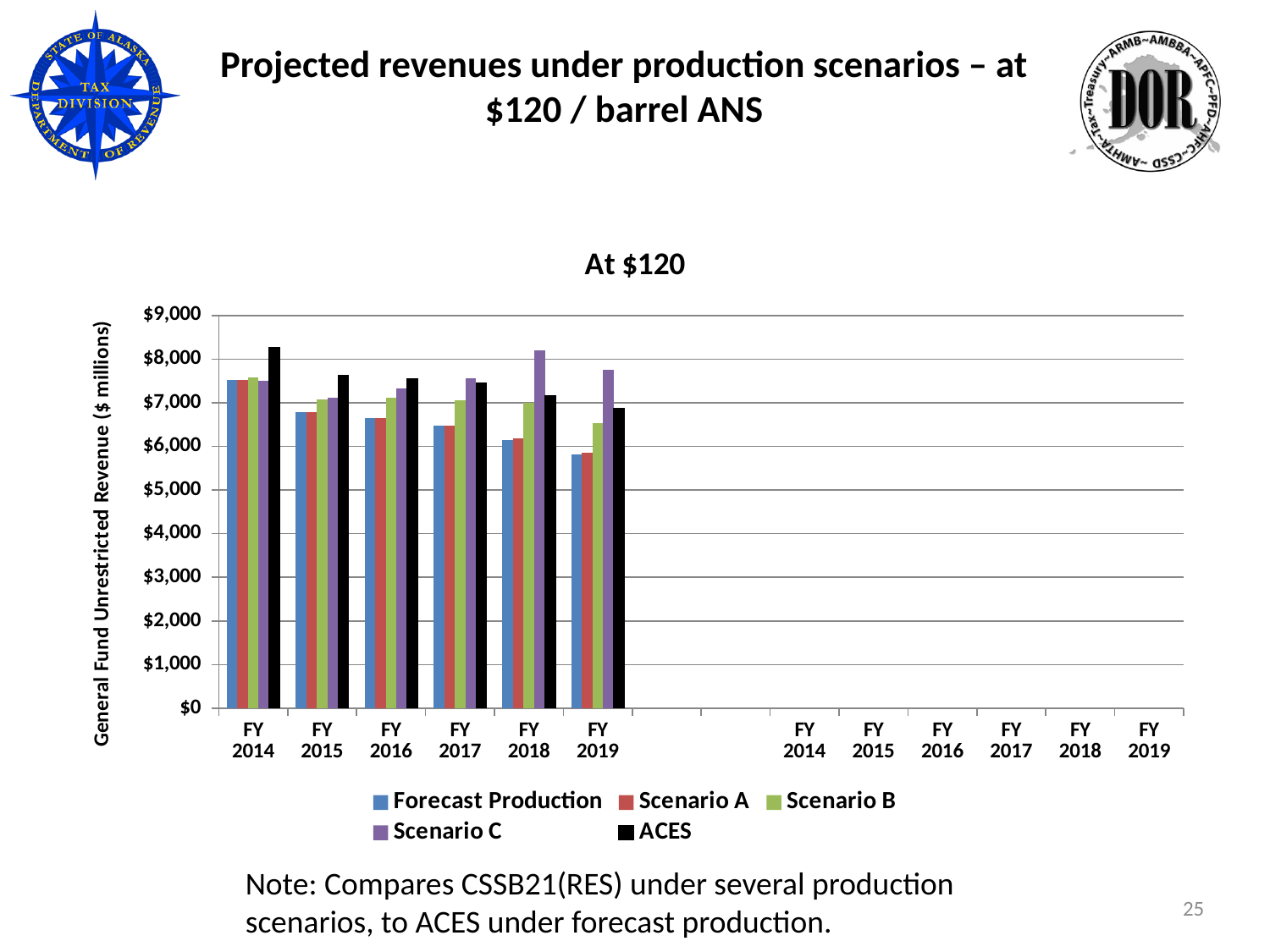
Is the Scenario C value for FY 2018 greater or less than $8,000? greater What kind of chart is shown on the slide? bar chart How many fiscal years have bars plotted in the chart? 6 In FY 2015, which is larger: ACES or Scenario B? ACES Does the Forecast Production value rise or fall from FY 2014 to FY 2019? fall In FY 2019, which is larger: Scenario C or ACES? Scenario C What is the title of the vertical axis? General Fund Unrestricted Revenue ($ millions) Which series has the highest value in FY 2018? Scenario C Is the ACES value for FY 2014 greater or less than $8,000? greater Which series has the highest value in FY 2014? ACES Is the Forecast Production value for FY 2019 greater or less than $6,000? less How many series does the legend list? 5